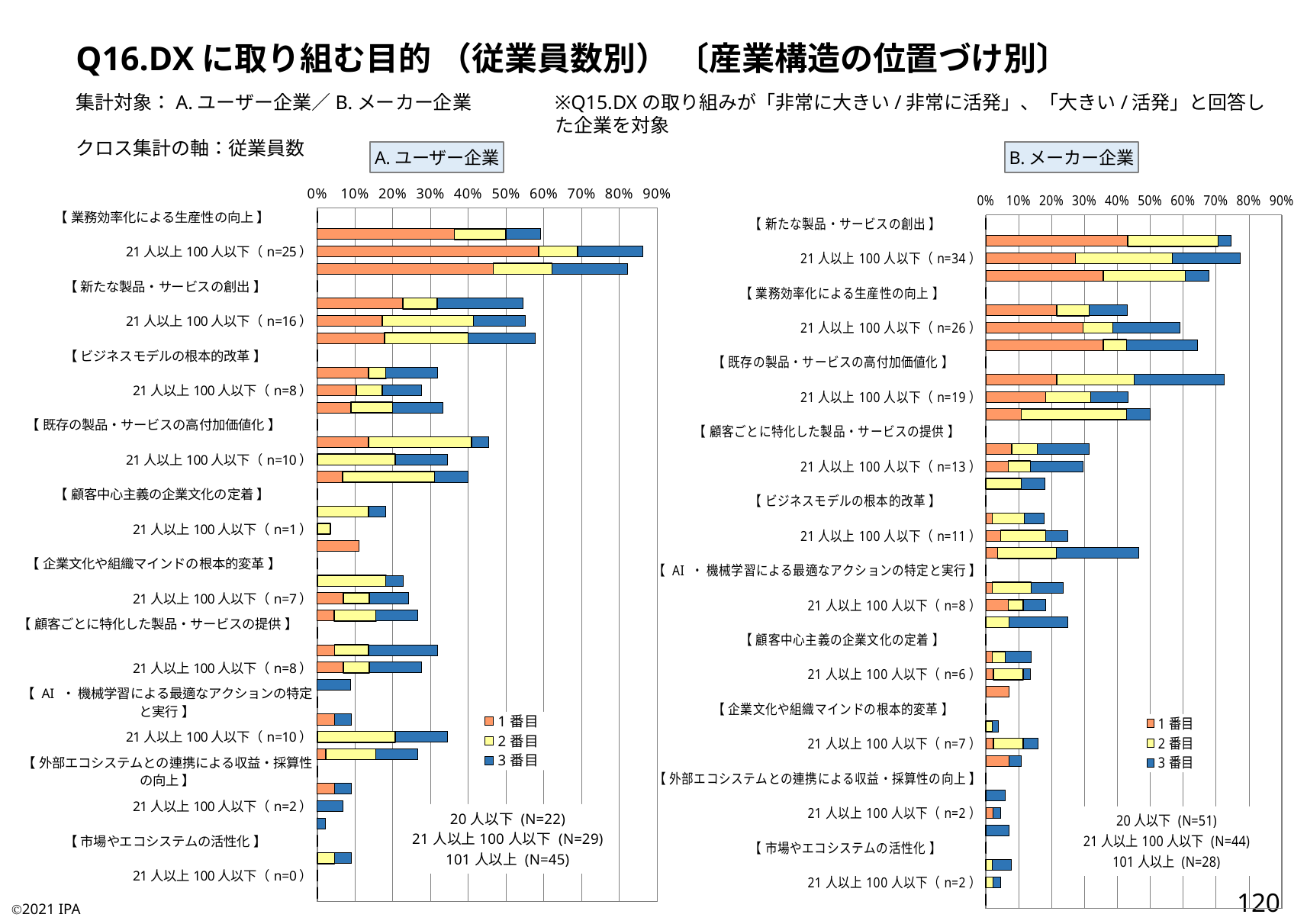
In the B. メーカー企業 chart, what is the N for 20人以下 shown in the text box? N=51 What are the legend entries of the A. ユーザー企業 chart? 1番目, 2番目, 3番目 In the B. メーカー企業 chart, is the total bar for 業務効率化による生産性の向上, 21人以上100人以下 (n=26) greater or less than 50%? greater What kind of chart is the A. ユーザー企業 chart? bar chart In the B. メーカー企業 chart, which total bar is longer: the first bar under 既存の製品・サービスの高付加価値化 or the first bar under 顧客ごとに特化した製品・サービスの提供? 既存の製品・サービスの高付加価値化 What is the highest percentage tick shown on the x axis of the A. ユーザー企業 chart? 90% In the B. メーカー企業 chart, is the total bar for 企業文化や組織マインドの根本的変革, 21人以上100人以下 (n=7) greater or less than 20%? less In the B. メーカー企業 chart, is the total bar for 新たな製品・サービスの創出, 21人以上100人以下 (n=34) greater or less than 70%? greater How many series does the legend of the B. メーカー企業 chart list? 3 In the A. ユーザー企業 chart, which total bar is longer: 業務効率化による生産性の向上, 21人以上100人以下 (n=25) or 新たな製品・サービスの創出, 21人以上100人以下 (n=16)? 業務効率化による生産性の向上, 21人以上100人以下 (n=25)